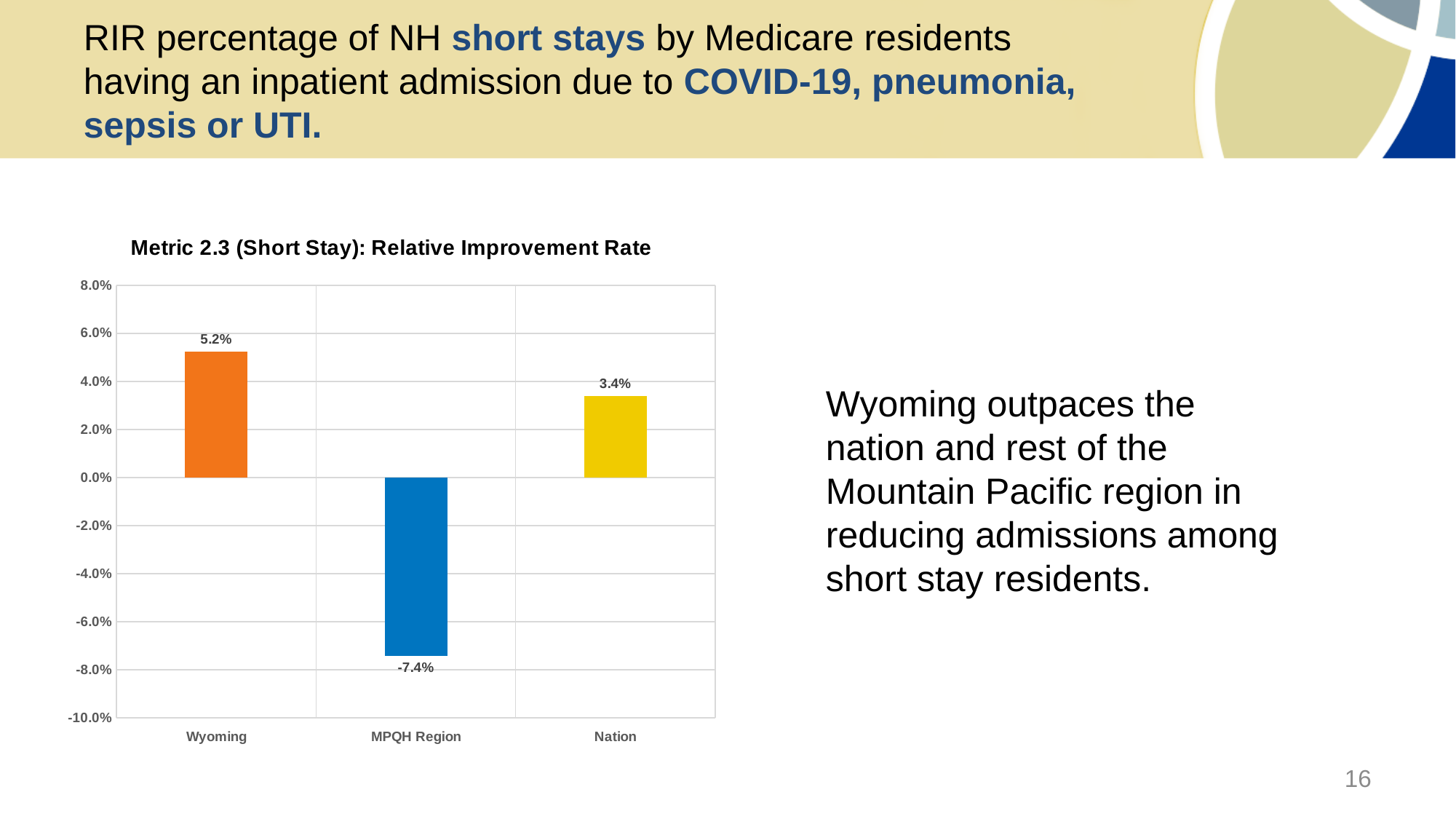
What is the relative improvement rate for the MPQH Region? -7.4% What is the relative improvement rate for the Nation? 3.4% What is the relative improvement rate for Wyoming? 5.2% Which category has the highest relative improvement rate? Wyoming How many categories are shown in the chart? 3 What is the difference between the relative improvement rates of Wyoming and the Nation? 1.8% What kind of chart is shown on the slide? Bar chart What colour is the bar for the MPQH Region? Blue Is the value for the MPQH Region greater or less than -6.0%? less What is the title of the chart? Metric 2.3 (Short Stay): Relative Improvement Rate Which category has the lowest relative improvement rate? MPQH Region Which has a larger relative improvement rate, Wyoming or the Nation? Wyoming